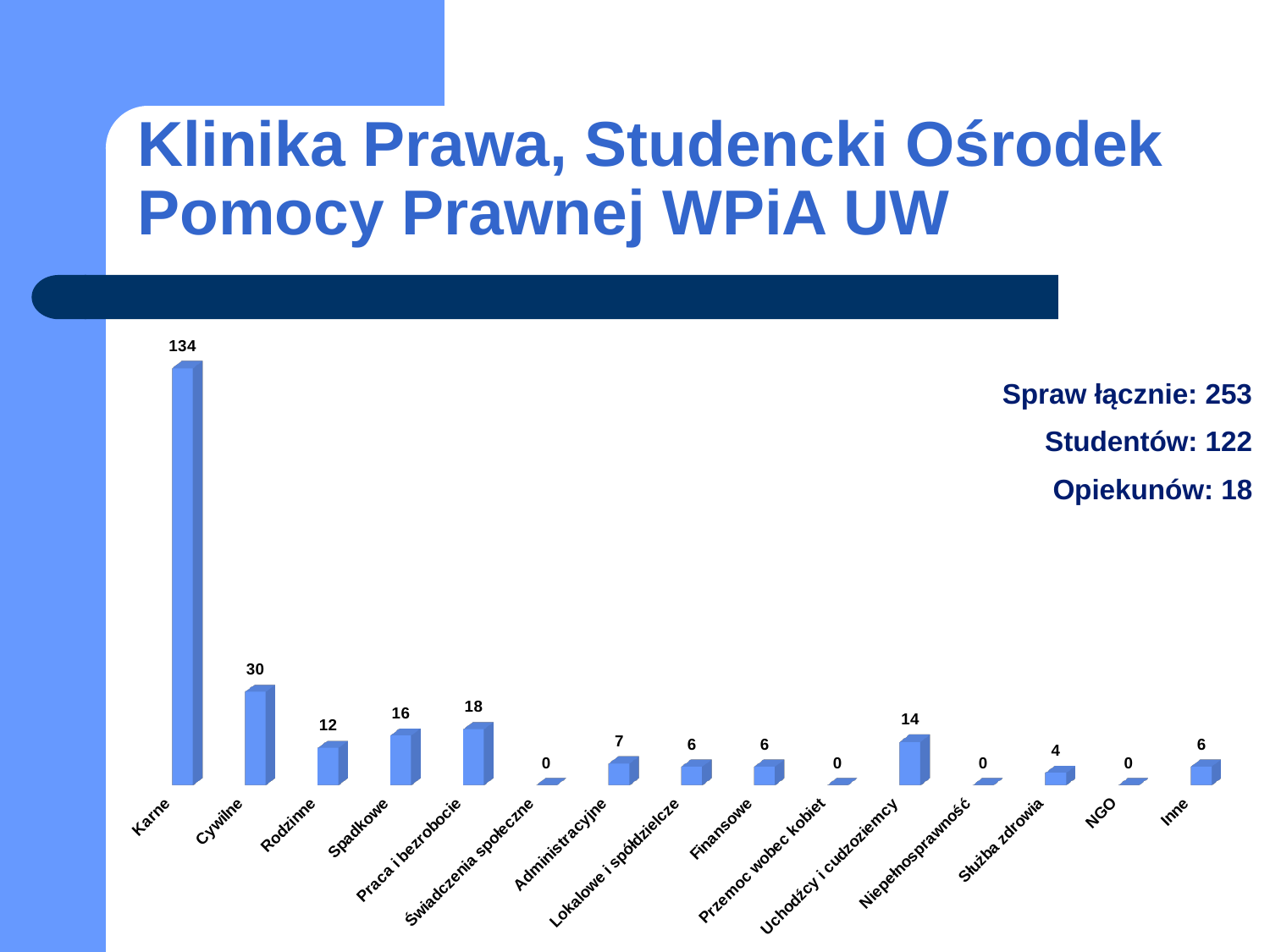
How many categories are shown on the x axis? 15 What is the difference between the values for Praca i bezrobocie and Spadkowe? 2 What is the value for Karne? 134 What kind of chart is shown on the slide? Bar chart Which category has the highest value? Karne What total number of cases (Spraw łącznie) is stated on the slide? 253 Which is larger, the value for Rodzinne or the value for Administracyjne? Rodzinne What is the difference between the values for Karne and Cywilne? 104 How many categories have a value of 0? 4 What is the value for Cywilne? 30 What is the value for Uchodźcy i cudzoziemcy? 14 What is the value for Służba zdrowia? 4